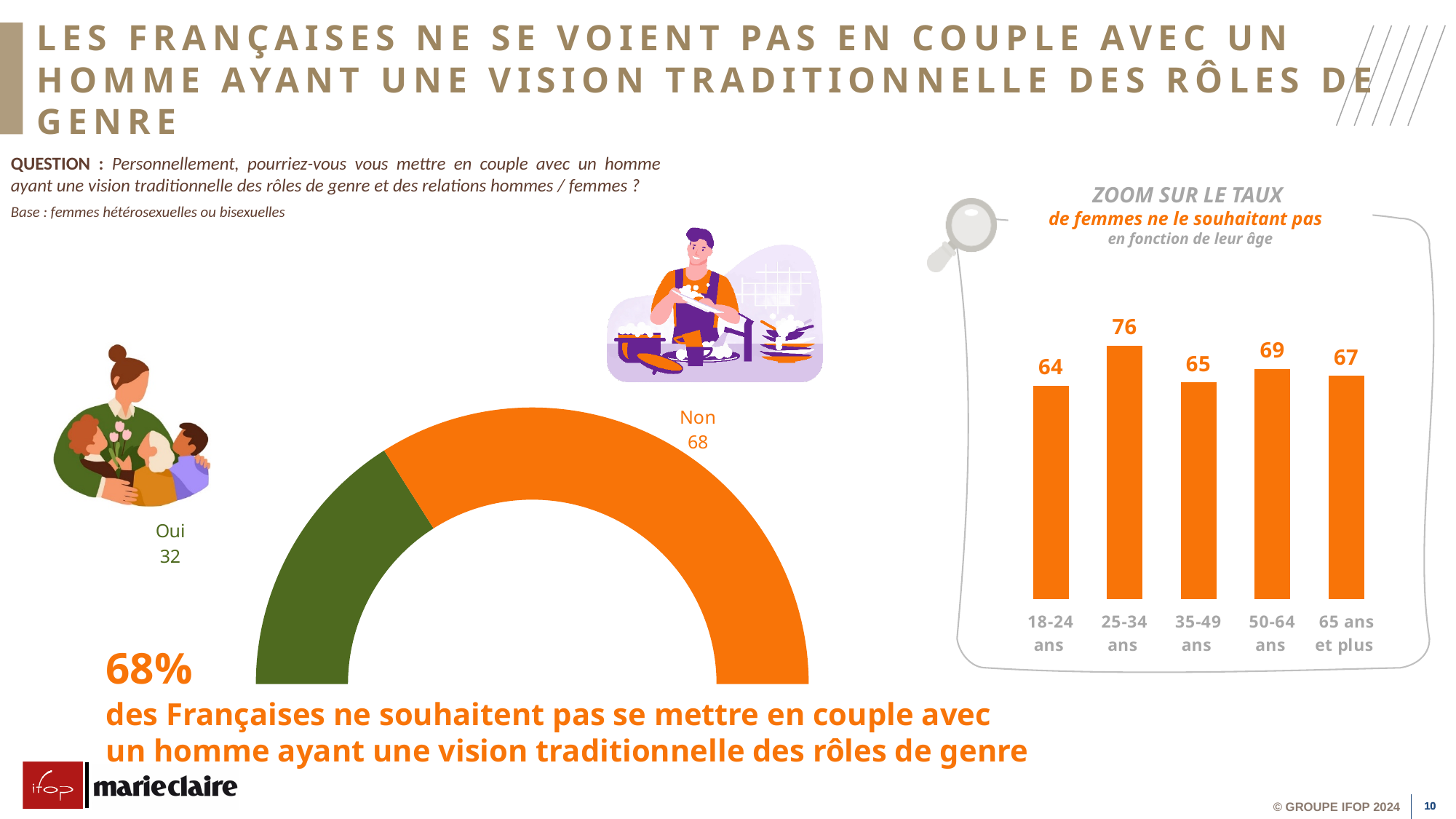
In the semicircle chart on the left, what is the value for Non? 68 In the bar chart on the right, which age group has the highest value? 25-34 ans In the bar chart on the right, what is the difference between the values for 25-34 ans and 18-24 ans? 12 What kind of chart is the chart on the right showing values by age? bar chart In the bar chart on the right, what is the value for 18-24 ans? 64 In the bar chart on the right, which age group has the lowest value? 18-24 ans How many age groups are shown in the bar chart on the right? 5 In the semicircle chart on the left, what is the value for Oui? 32 In the bar chart on the right, what is the value for 25-34 ans? 76 In the bar chart on the right, which is larger: the value for 50-64 ans or the value for 35-49 ans? 50-64 ans In the semicircle chart on the left, which segment is larger, Oui or Non? Non In the bar chart on the right, what is the value for 65 ans et plus? 67